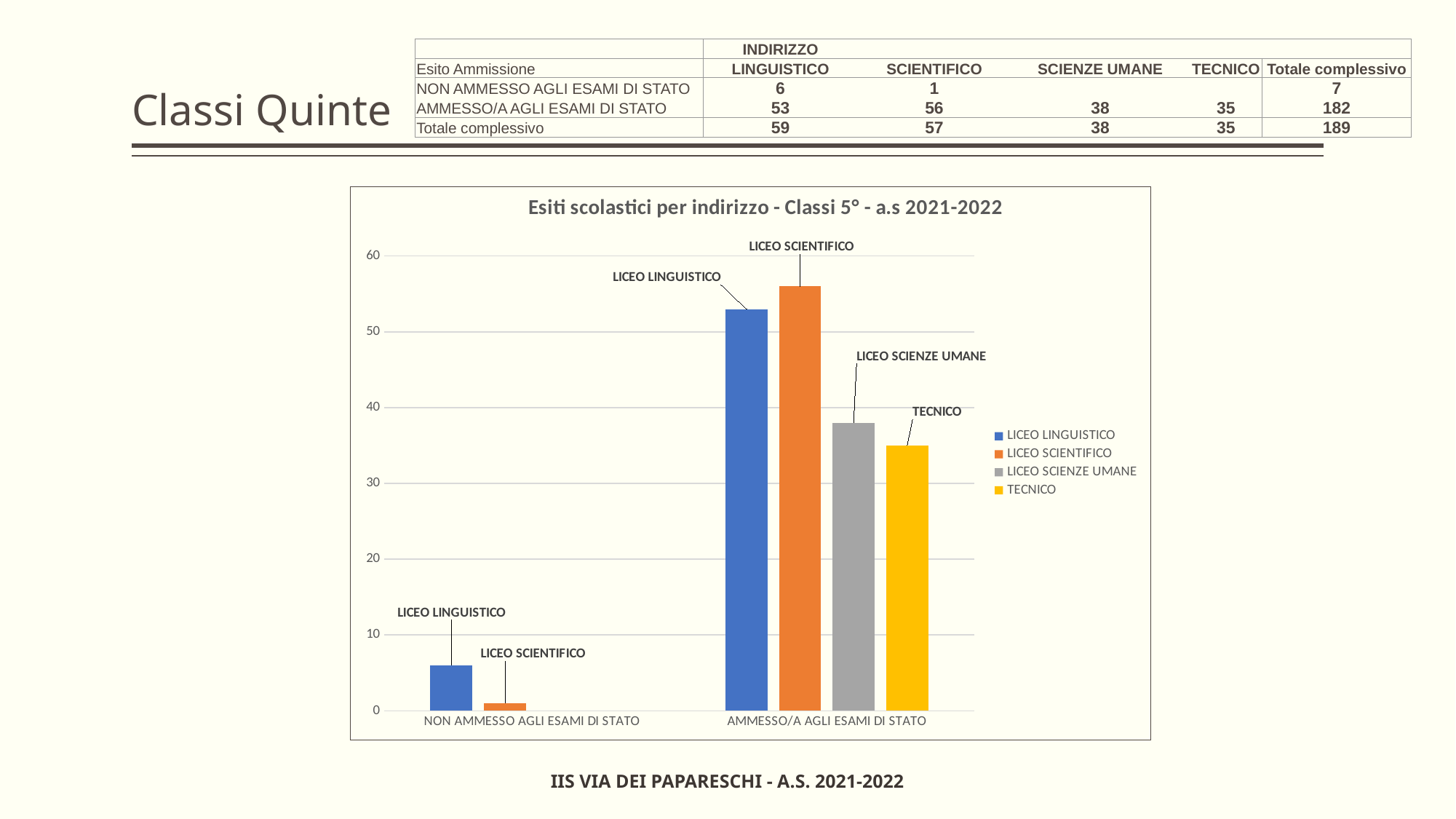
What is the title of the chart? Esiti scolastici per indirizzo - Classi 5° - a.s 2021-2022 Is the LICEO SCIENTIFICO bar for AMMESSO/A AGLI ESAMI DI STATO greater or less than 50? greater What kind of chart is shown on the slide? bar chart Is the TECNICO bar for AMMESSO/A AGLI ESAMI DI STATO greater or less than 40? less Which series has the lowest bar in the AMMESSO/A AGLI ESAMI DI STATO category? TECNICO Which series has the highest bar in the AMMESSO/A AGLI ESAMI DI STATO category? LICEO SCIENTIFICO How many categories are shown on the x axis of the chart? 2 Which colour represents TECNICO in the chart legend? yellow Is the LICEO LINGUISTICO bar for NON AMMESSO AGLI ESAMI DI STATO greater or less than 10? less How many series does the chart legend list? 4 According to the table, how many LICEO LINGUISTICO students were AMMESSO/A AGLI ESAMI DI STATO? 53 In the NON AMMESSO AGLI ESAMI DI STATO category, which bar is taller, LICEO LINGUISTICO or LICEO SCIENTIFICO? LICEO LINGUISTICO